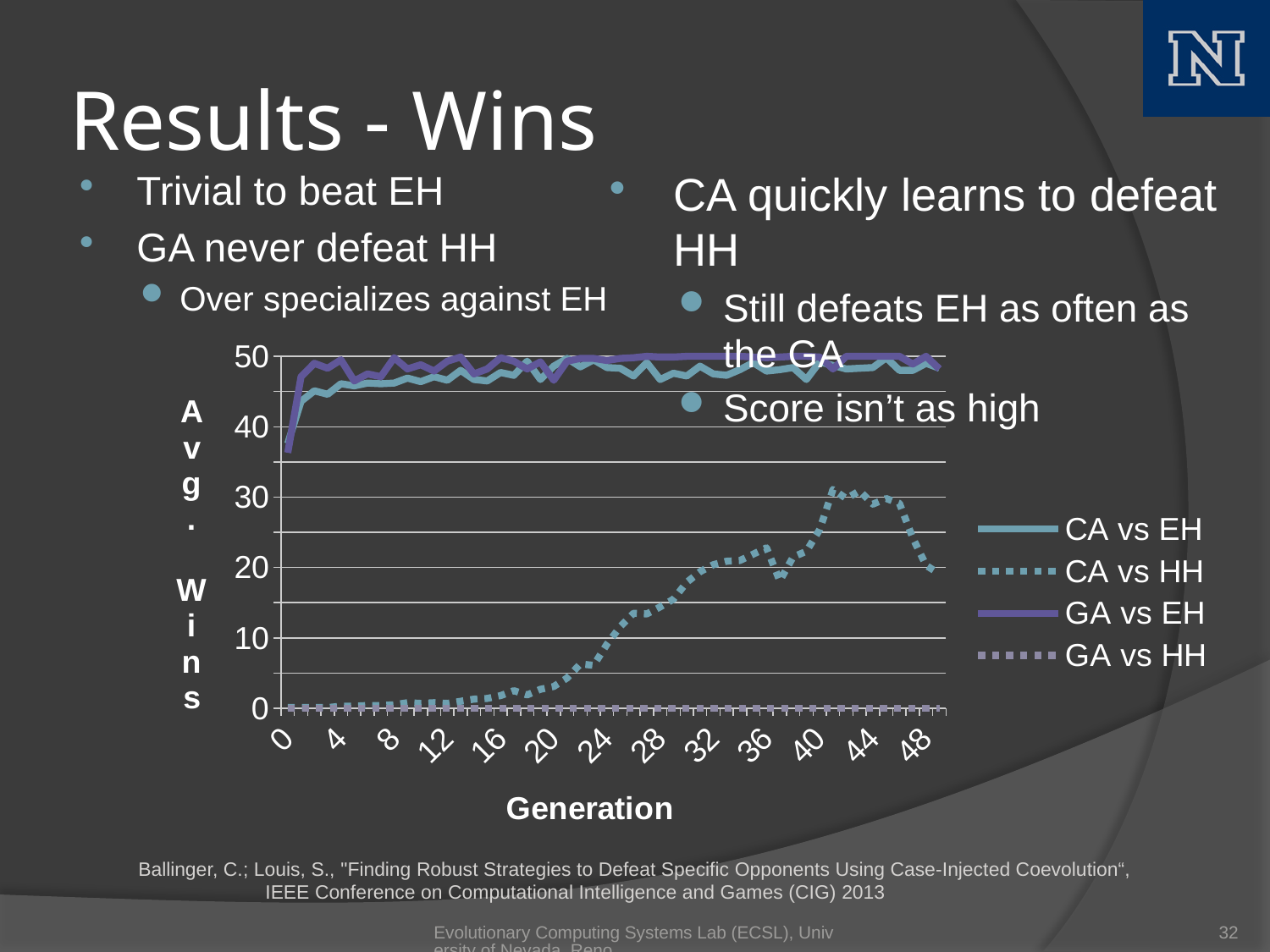
How many series does the chart legend list? 4 Is the value for GA vs EH at generation 48 greater or less than 40? greater Does the CA vs HH series generally rise or fall as generation increases? rise Which series has the lowest values across the generations shown? GA vs HH Is the value for CA vs HH at generation 28 greater or less than 10? greater What is the title of the x axis of the chart? Generation At generation 44, which series has the larger value: CA vs HH or GA vs HH? CA vs HH Is the value for GA vs HH at generation 40 greater or less than 10? less How many generation labels are shown on the x axis? 13 Which series are listed in the chart legend? CA vs EH, CA vs HH, GA vs EH, GA vs HH What kind of chart is shown on the slide? line chart